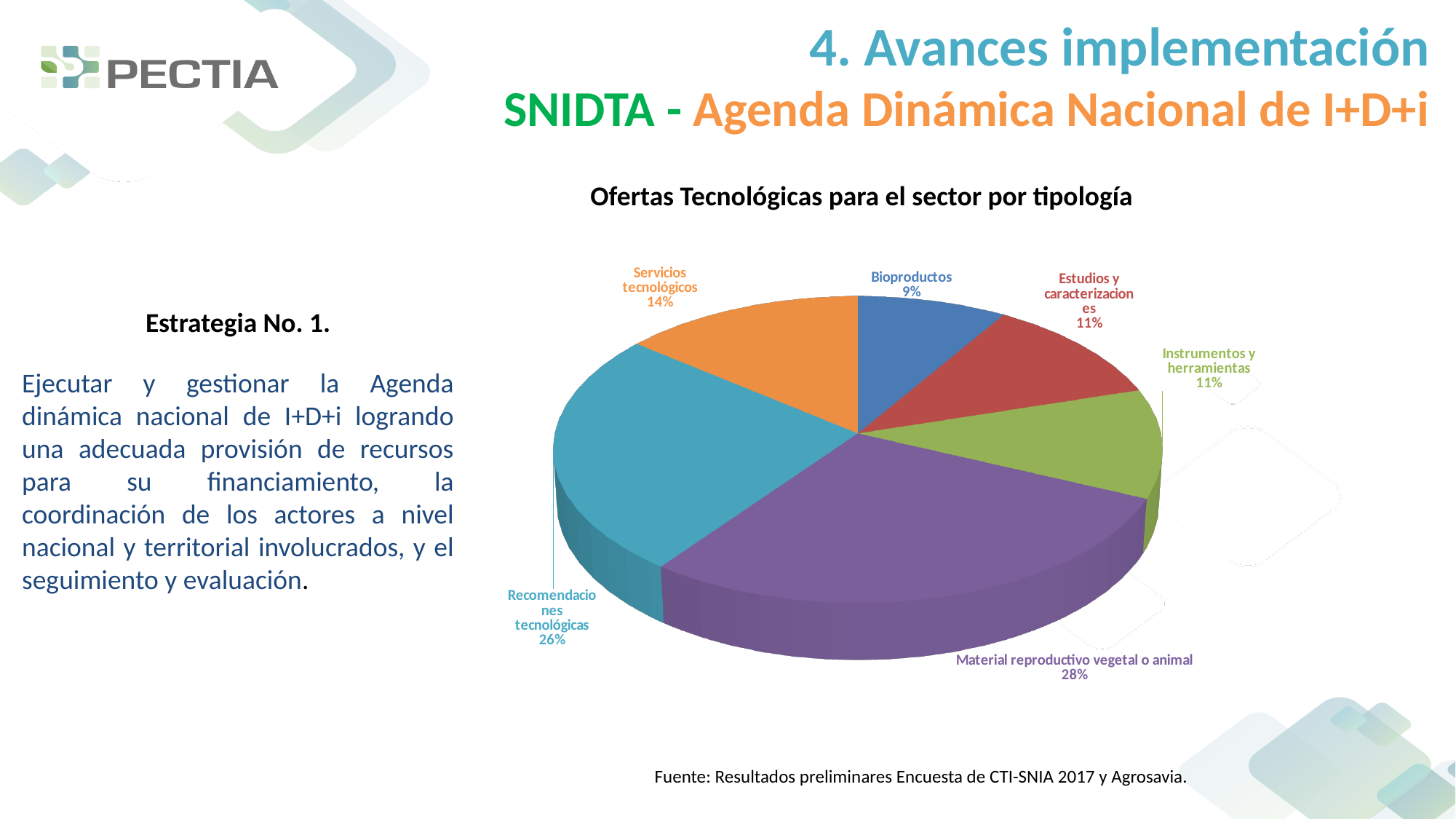
What share does Recomendaciones tecnológicas have in the pie chart? 26% Which category has the smallest slice of the pie? Bioproductos What is the title of the chart? Ofertas Tecnológicas para el sector por tipología What is the value shown for Bioproductos? 9% What is the value shown for Servicios tecnológicos? 14% How many categories are shown in the pie chart? 6 Which category has the largest slice of the pie? Material reproductivo vegetal o animal What is the value shown for Instrumentos y herramientas? 11% What is the difference between the shares of Material reproductivo vegetal o animal and Recomendaciones tecnológicas? 2% Which is larger, the share for Servicios tecnológicos or the share for Estudios y caracterizaciones? Servicios tecnológicos What kind of chart is shown on the slide? Pie chart What share does Material reproductivo vegetal o animal have in the pie chart? 28%